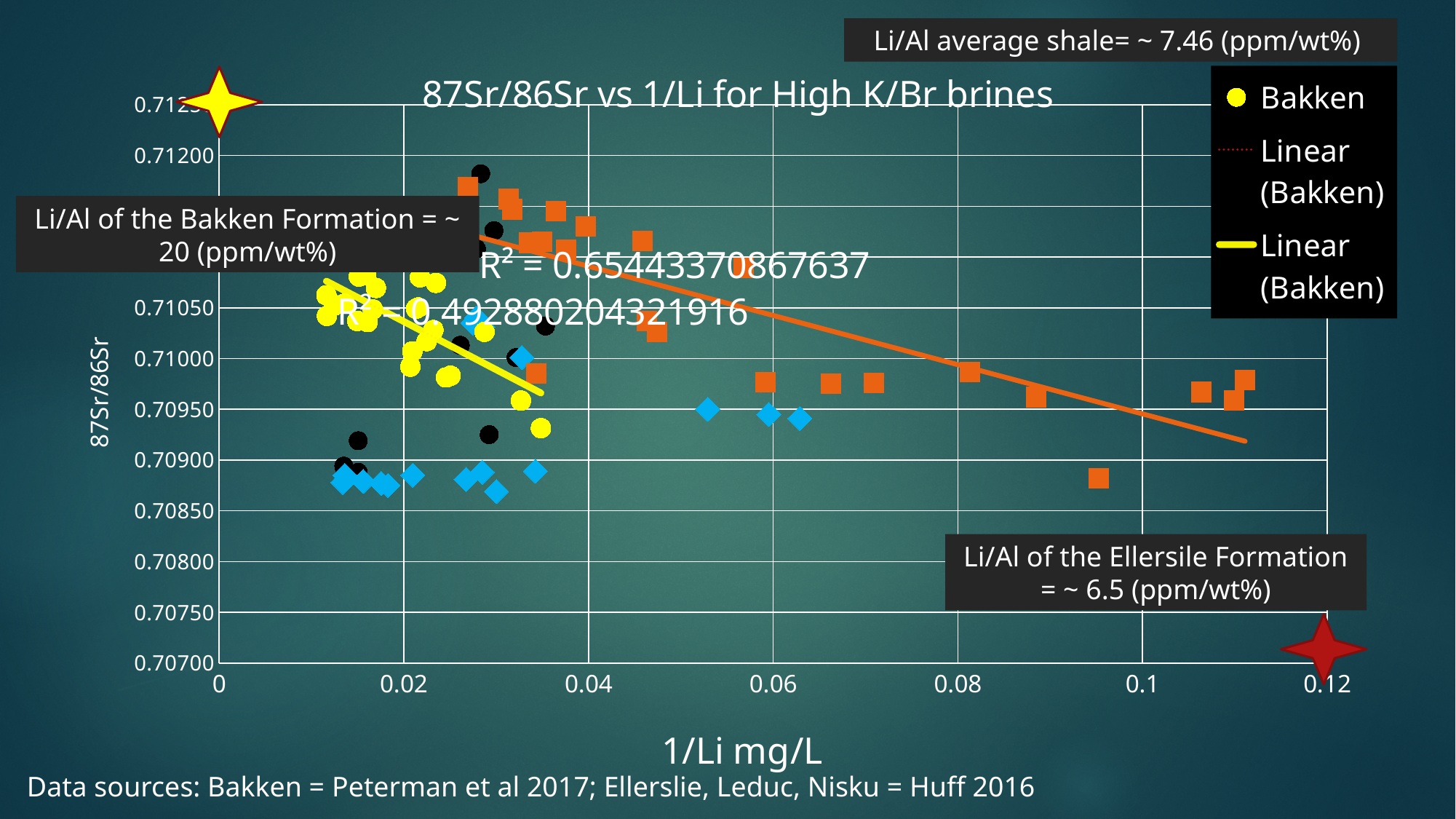
Do the fitted linear trend lines rise or fall as 1/Li increases along the x axis? fall What is the maximum value shown on the x axis? 0.12 How many entries does the chart legend list? 3 Is the 87Sr/86Sr value of the highest orange square near 1/Li = 0.027 greater or less than 0.71100? greater What is the label of the x axis? 1/Li mg/L What is the title of the chart? 87Sr/86Sr vs 1/Li for High K/Br brines Are the 87Sr/86Sr values of the blue diamonds plotted near 1/Li = 0.015 greater or less than 0.70900? less What is the smaller R² value printed on the chart? 0.492880204321916 What kind of chart is shown on the slide? scatter chart What is the larger R² value printed on the chart? 0.65443370867637 Which series has points that extend furthest to the right along the x axis, the orange squares or the yellow circles? orange squares